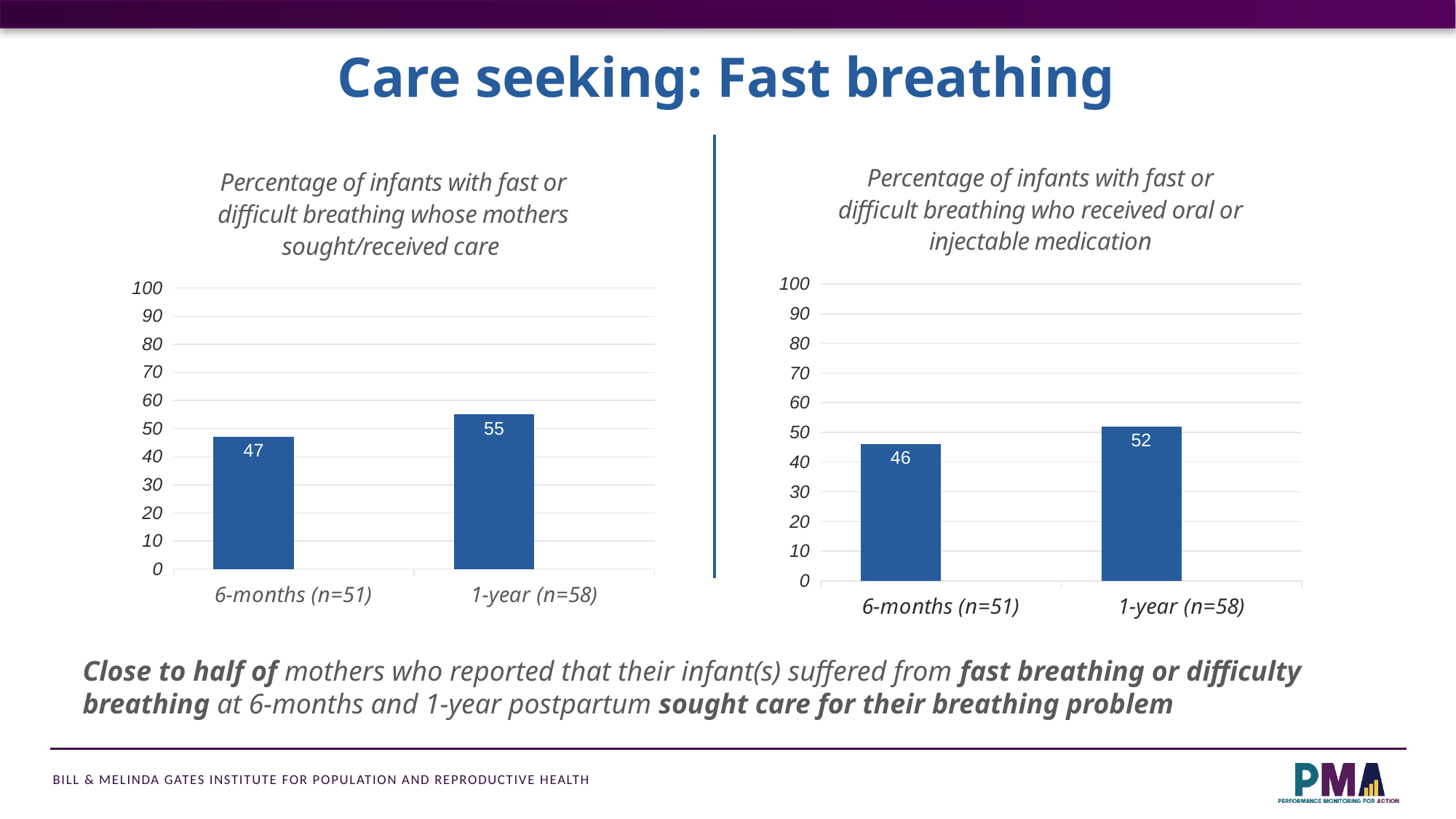
In the right chart (received oral or injectable medication), what is the value for 6-months (n=51)? 46 In the left chart (mothers sought/received care), which category has the highest value? 1-year (n=58) In the left chart (mothers sought/received care), what is the value for 1-year (n=58)? 55 How many categories are shown on the x axis of the left chart (mothers sought/received care)? 2 In the left chart (mothers sought/received care), what is the difference between the 1-year and 6-months values? 8 In the right chart (received oral or injectable medication), what is the value for 1-year (n=58)? 52 In the left chart (mothers sought/received care), do the values rise or fall from 6-months to 1-year? Rise In the right chart (received oral or injectable medication), which category has the lowest value? 6-months (n=51) What kind of chart is the right chart (received oral or injectable medication)? Bar chart In the right chart (received oral or injectable medication), what is the difference between the 1-year and 6-months values? 6 In the right chart (received oral or injectable medication), is the value for 1-year (n=58) greater or less than 50? greater In the left chart (mothers sought/received care), what is the value for 6-months (n=51)? 47